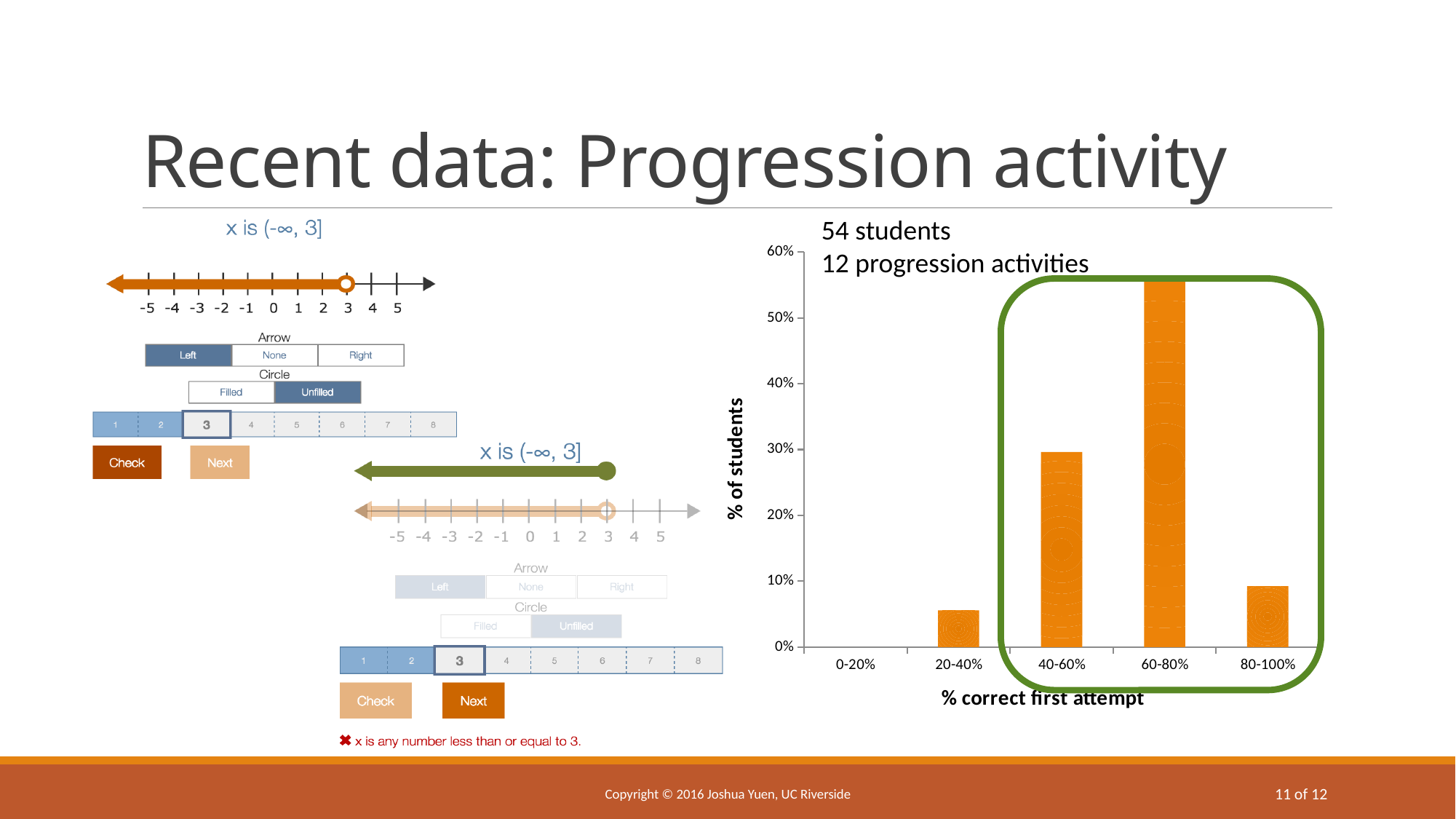
Which category has the lowest percentage of students in the bar chart? 0-20% What is the label of the y axis of the bar chart? % of students What kind of chart is shown on the right side of the slide? bar chart Which category has the highest percentage of students in the bar chart? 60-80% Is the value for 40-60% greater or less than 20%? greater How many categories are shown on the x axis of the bar chart? 5 Is the value for 60-80% greater or less than 50%? greater Which category has a larger value, 20-40% or 80-100%? 80-100% Is the value for 20-40% greater or less than 10%? less Which category has a larger value, 40-60% or 80-100%? 40-60% What is the label of the x axis of the bar chart? % correct first attempt